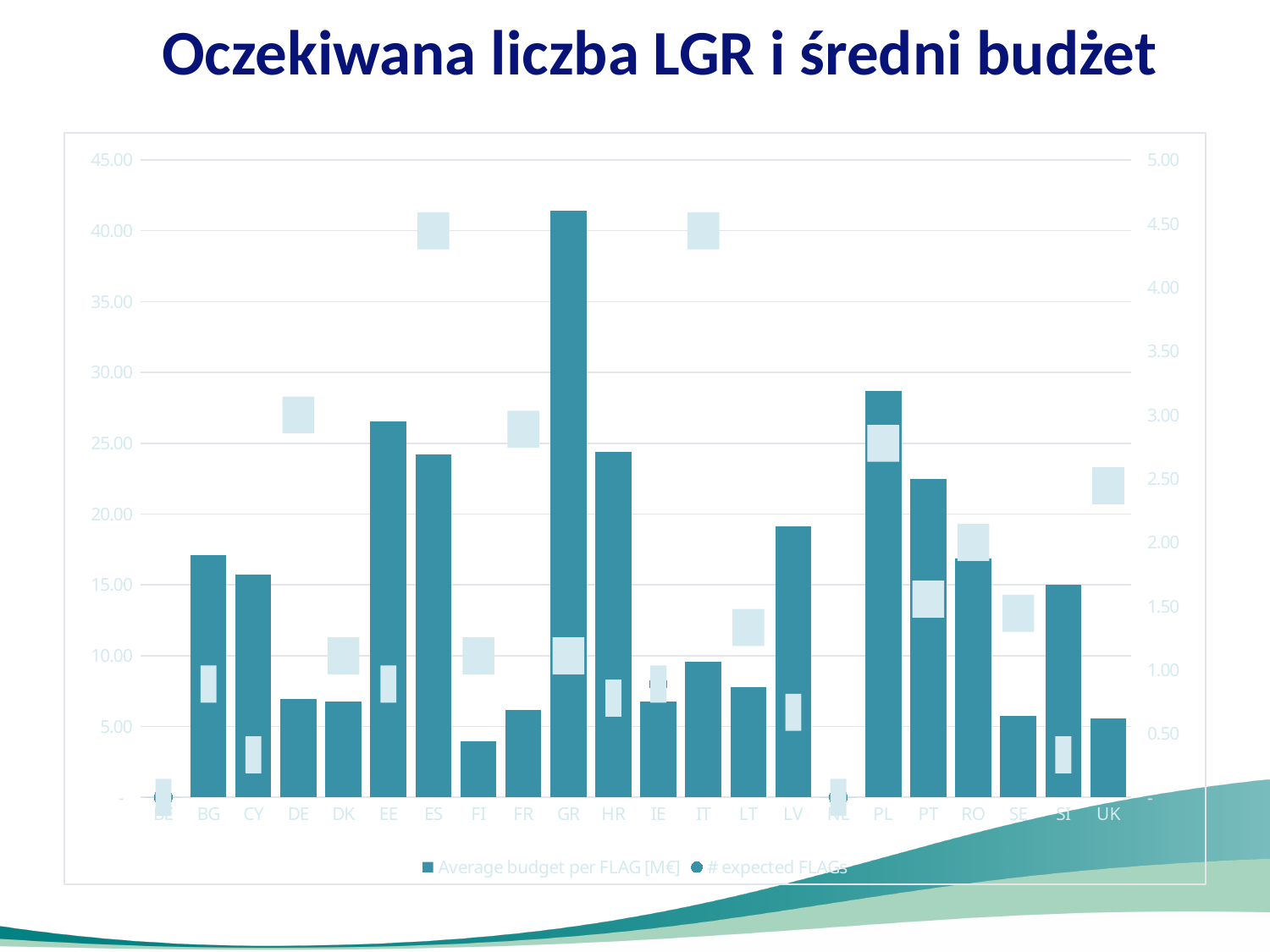
Which has the larger Average budget per FLAG [M€] bar, PT or RO? PT Is the # expected FLAGs marker for ES greater or less than 4.00 on the right axis? greater Is the Average budget per FLAG [M€] bar for DE greater or less than 10.00? less Is the Average budget per FLAG [M€] bar for GR greater or less than 35.00? greater Which has the larger Average budget per FLAG [M€] bar, LV or SI? LV Which country has the tallest bar for Average budget per FLAG [M€]? GR How many series does the legend list? 2 How many country categories are shown on the x axis? 22 What are the two series named in the legend? Average budget per FLAG [M€] and # expected FLAGs What is the title of the chart? Oczekiwana liczba LGR i średni budżet